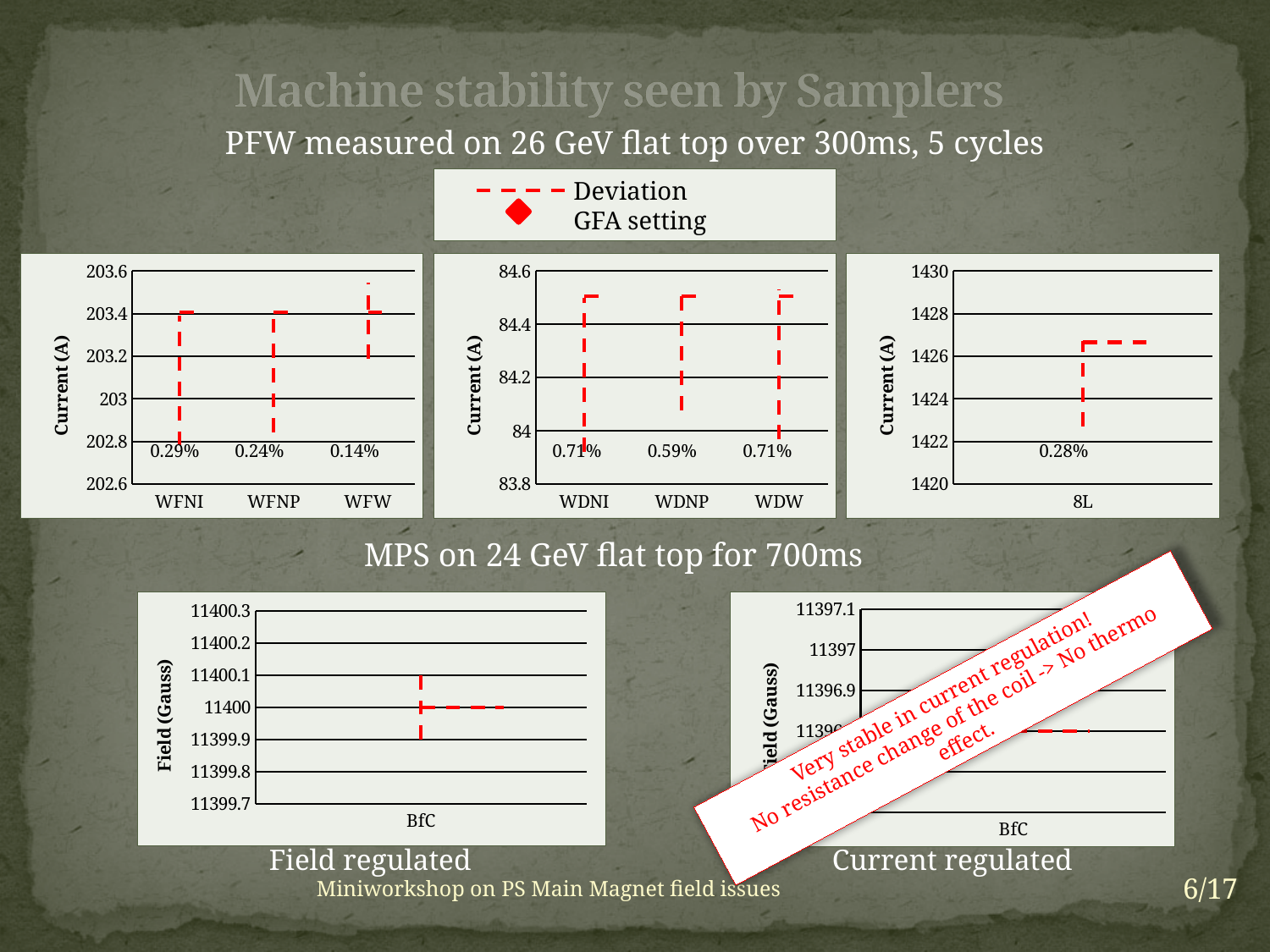
What is the y-axis title of the bottom-left chart labelled 'Field regulated'? Field (Gauss) How many categories are shown on the x axis of the top-middle chart (WDNI, WDNP, WDW)? 3 In the top-middle chart (WDNI, WDNP, WDW), is the printed percentage for WDNI larger or smaller than that for WDNP? larger In the top-left chart (WFNI, WFNP, WFW), what percentage is printed for WFNI? 0.29% In the top-left chart (WFNI, WFNP, WFW), what is the difference between the printed percentages for WFNI and WFNP? 0.05% In the top-left chart (WFNI, WFNP, WFW), which category has the lowest printed percentage? WFW In the top-right chart, what percentage is printed for 8L? 0.28% How many series does the legend above the top row of charts list? 2 In the top-left chart (WFNI, WFNP, WFW), what percentage is printed for WFW? 0.14% In the top-middle chart (WDNI, WDNP, WDW), what percentage is printed for WDNP? 0.59% What category label appears on the x axis of the bottom-left chart labelled 'Field regulated'? BfC In the top-middle chart (WDNI, WDNP, WDW), which category has the lowest printed percentage? WDNP